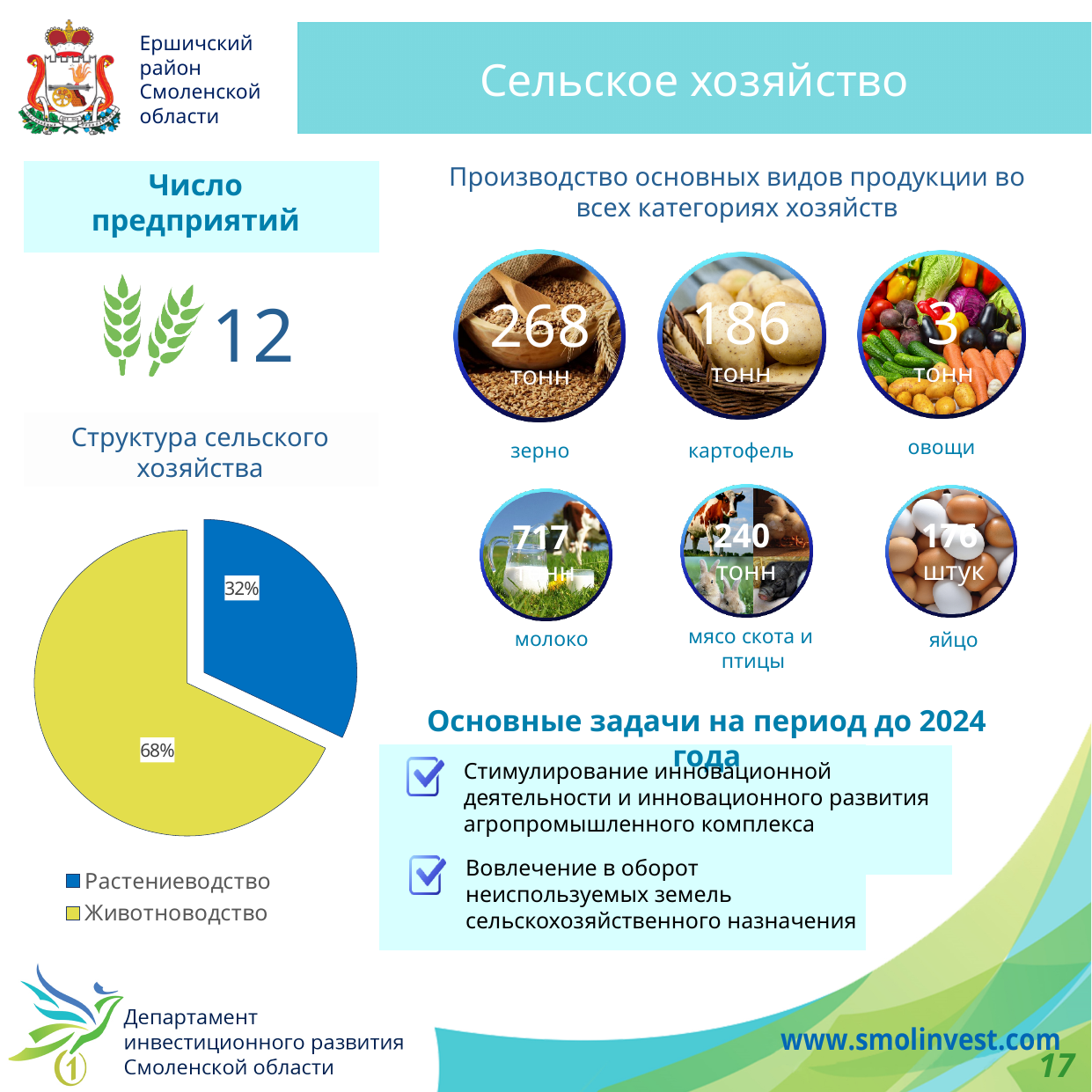
What colour is the Животноводство slice in the pie chart "Структура сельского хозяйства"? yellow How many entries does the legend of the pie chart "Структура сельского хозяйства" list? 2 Which slice of the pie chart "Структура сельского хозяйства" is the smallest? Растениеводство How many slices does the pie chart "Структура сельского хозяйства" have? 2 What kind of chart is shown under the heading "Структура сельского хозяйства"? pie chart What colour is the Растениеводство slice in the pie chart "Структура сельского хозяйства"? blue In the pie chart "Структура сельского хозяйства", which is larger: Растениеводство or Животноводство? Животноводство Which slice of the pie chart "Структура сельского хозяйства" is the largest? Животноводство In the pie chart "Структура сельского хозяйства", what share does Животноводство have? 68% In the pie chart "Структура сельского хозяйства", by how many percentage points does Животноводство exceed Растениеводство? 36 percentage points In the pie chart "Структура сельского хозяйства", what share does Растениеводство have? 32%